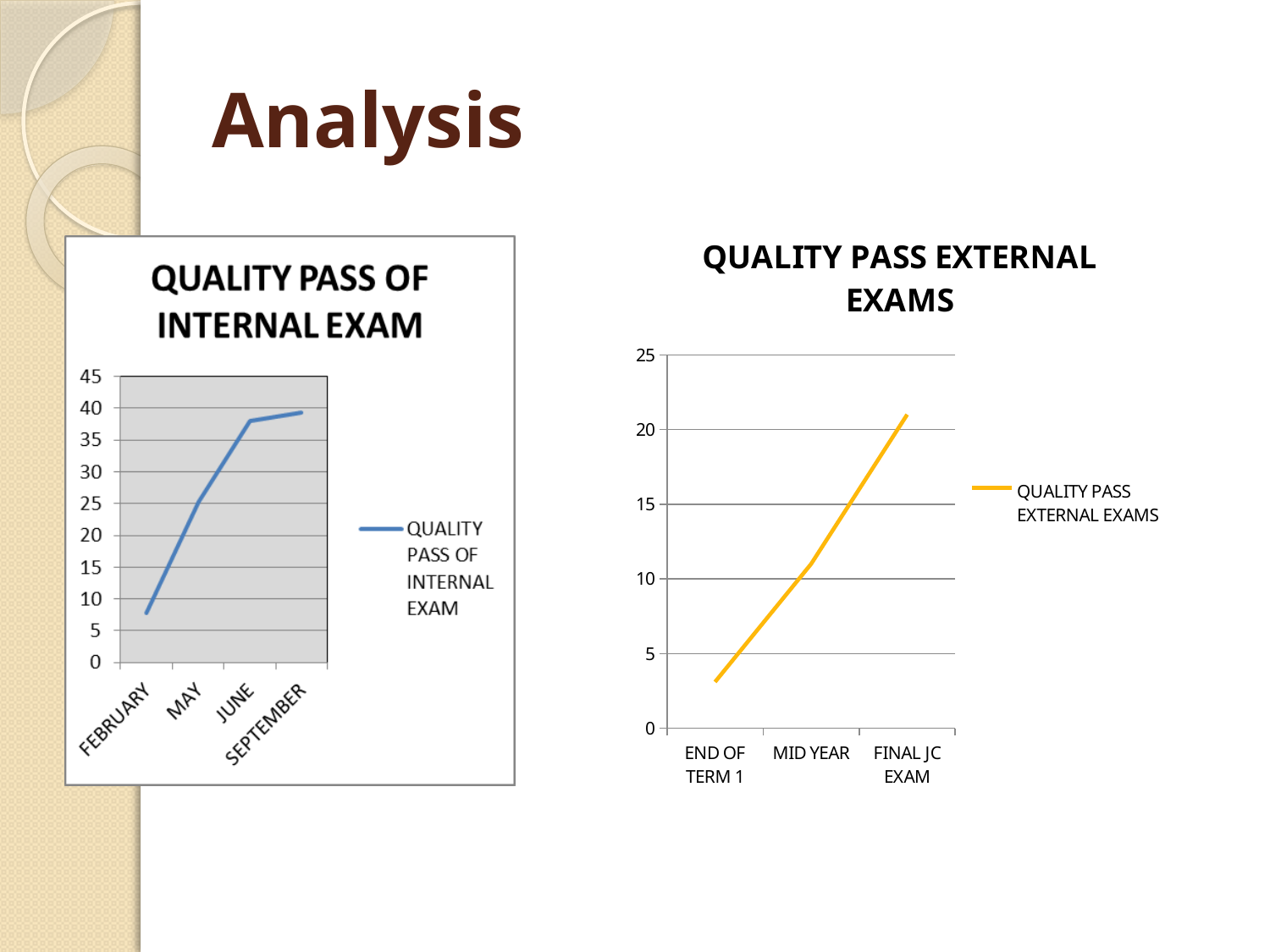
What colour is the line in the 'QUALITY PASS EXTERNAL EXAMS' chart? Orange What kind of chart is the 'QUALITY PASS OF INTERNAL EXAM' chart? Line chart How many categories are shown on the x axis of the 'QUALITY PASS EXTERNAL EXAMS' chart? 3 In the 'QUALITY PASS OF INTERNAL EXAM' chart, is the value for MAY greater or less than 20? greater In the 'QUALITY PASS EXTERNAL EXAMS' chart, is the value for END OF TERM 1 greater or less than 5? less In the 'QUALITY PASS EXTERNAL EXAMS' chart, do the values rise or fall from END OF TERM 1 to FINAL JC EXAM? Rise What kind of chart is the 'QUALITY PASS EXTERNAL EXAMS' chart? Line chart In the 'QUALITY PASS EXTERNAL EXAMS' chart, which category has the highest value? FINAL JC EXAM How many categories are shown on the x axis of the 'QUALITY PASS OF INTERNAL EXAM' chart? 4 How many series does the legend of the 'QUALITY PASS EXTERNAL EXAMS' chart list? 1 In the 'QUALITY PASS OF INTERNAL EXAM' chart, which month has the lowest value? FEBRUARY In the 'QUALITY PASS OF INTERNAL EXAM' chart, do the values rise or fall from FEBRUARY to SEPTEMBER? Rise